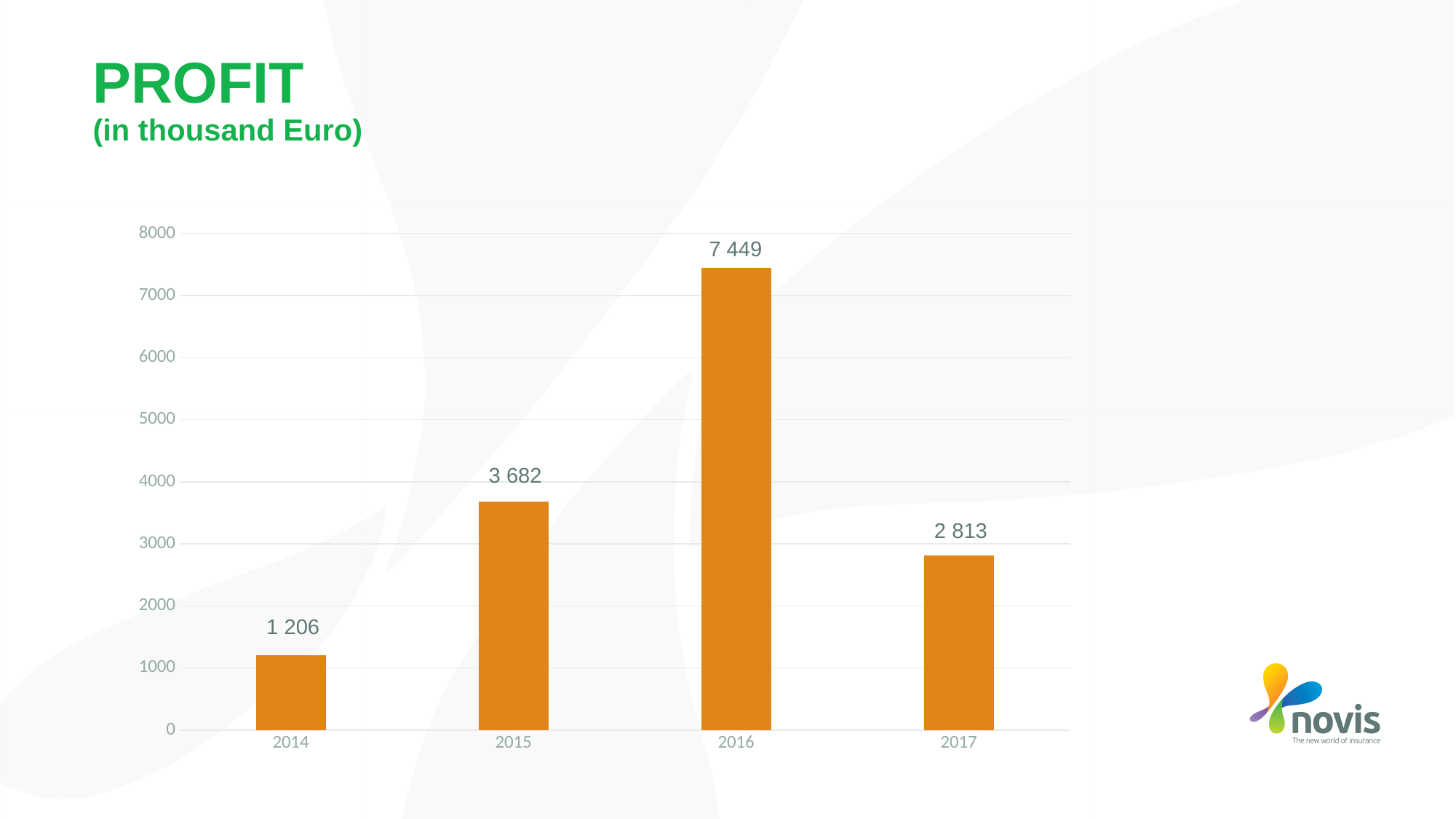
Which year had a larger profit, 2015 or 2017? 2015 In what unit is the profit expressed according to the chart title? Thousand Euro How many years are shown on the chart? 4 Which year had the lowest profit? 2014 Is the profit for 2015 greater or less than 3000? greater What is the difference in profit between 2016 and 2015? 3 767 Which year had the highest profit? 2016 What was the profit in 2016? 7 449 What is the difference in profit between 2017 and 2014? 1 607 What was the profit in 2017? 2 813 What was the profit in 2014? 1 206 What type of chart is shown on the slide? Bar chart